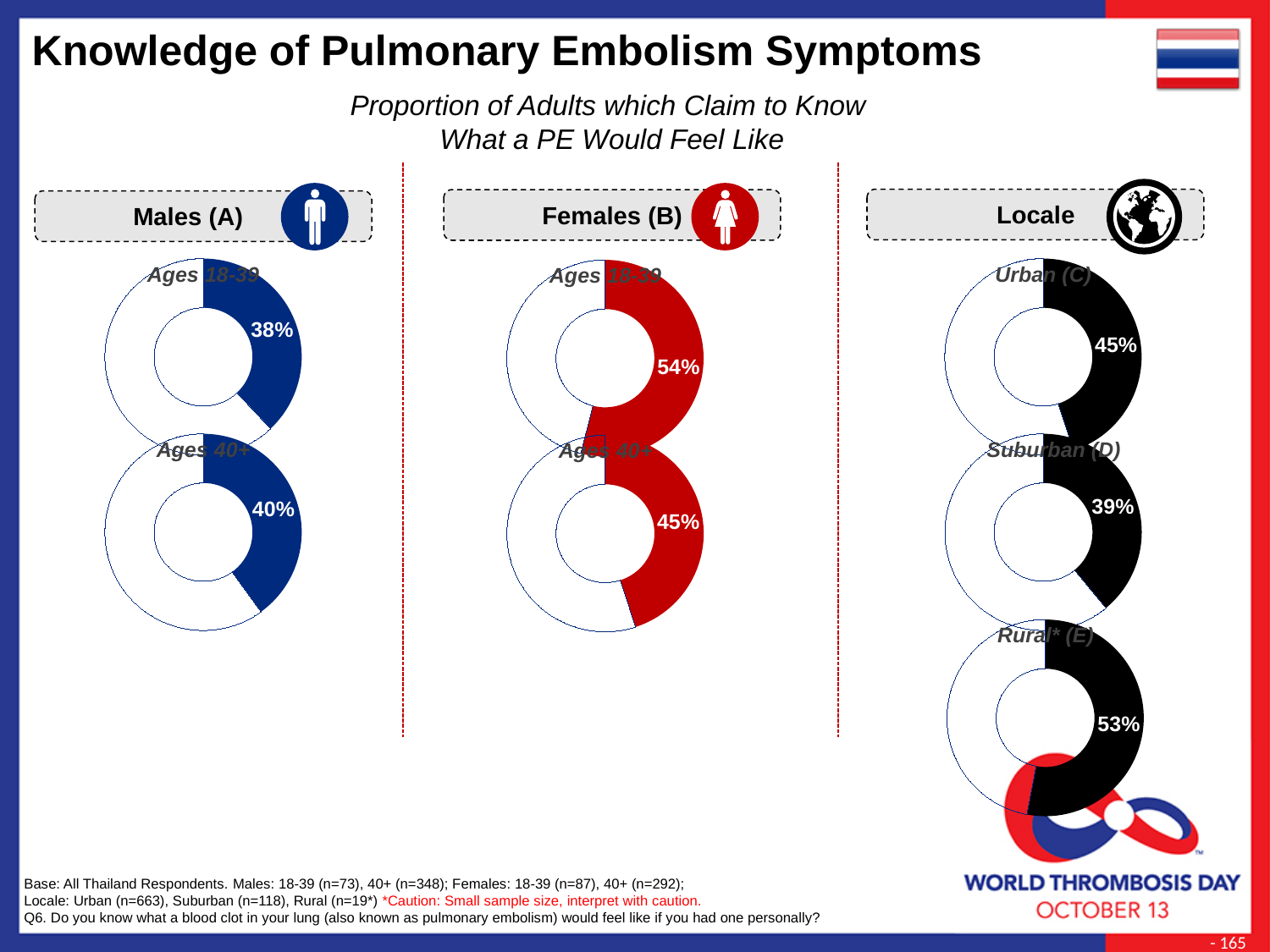
In the Locale Rural* (E) donut chart, what proportion of adults claim to know what a PE would feel like? 53% Comparing the Females (B) Ages 18-39 and Ages 40+ donut charts, what is the difference in percentage points between the two values? 9 percentage points In the Females (B) Ages 40+ donut chart, what proportion of adults claim to know what a PE would feel like? 45% In the Locale Suburban (D) donut chart, what proportion of adults claim to know what a PE would feel like? 39% In the Locale Urban (C) donut chart, what proportion of adults claim to know what a PE would feel like? 45% Among the three Locale donut charts, which locale has the lowest proportion claiming to know what a PE would feel like? Suburban (D) In the Females (B) Ages 18-39 donut chart, what proportion of adults claim to know what a PE would feel like? 54% Among the three Locale donut charts, which locale has the highest proportion claiming to know what a PE would feel like? Rural* (E) In the Males (A) Ages 18-39 donut chart, what proportion of adults claim to know what a PE would feel like? 38% Comparing the Males (A) Ages 18-39 donut chart and the Females (B) Ages 18-39 donut chart, which shows the larger proportion? Females (B) Ages 18-39 In the Males (A) Ages 40+ donut chart, what proportion of adults claim to know what a PE would feel like? 40% What type of chart is used to show the proportions on this slide? Donut (pie) chart